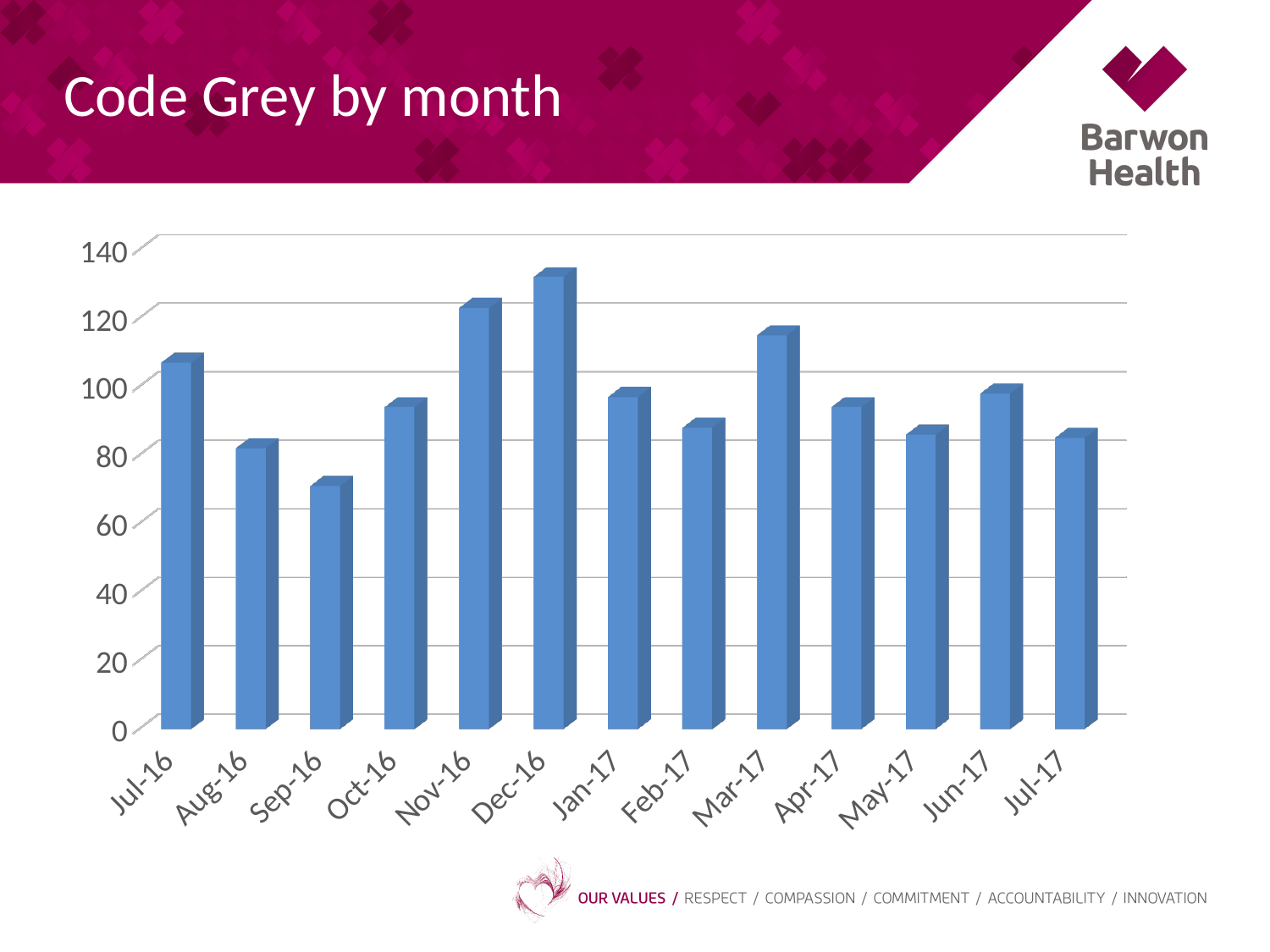
Is the value for Sep-16 greater or less than 80? less Which is larger, the value for Sep-16 or Oct-16? Oct-16 How many months are plotted on the chart? 13 Is the value for Mar-17 greater or less than 100? greater Is the value for Dec-16 greater or less than 120? greater Which is larger, the value for Nov-16 or Dec-16? Dec-16 Which month has the lowest value? Sep-16 What type of chart is shown on the slide? Bar chart Which month has the highest value? Dec-16 What is the title of the slide? Code Grey by month Do the values rise or fall from Sep-16 to Dec-16? Rise